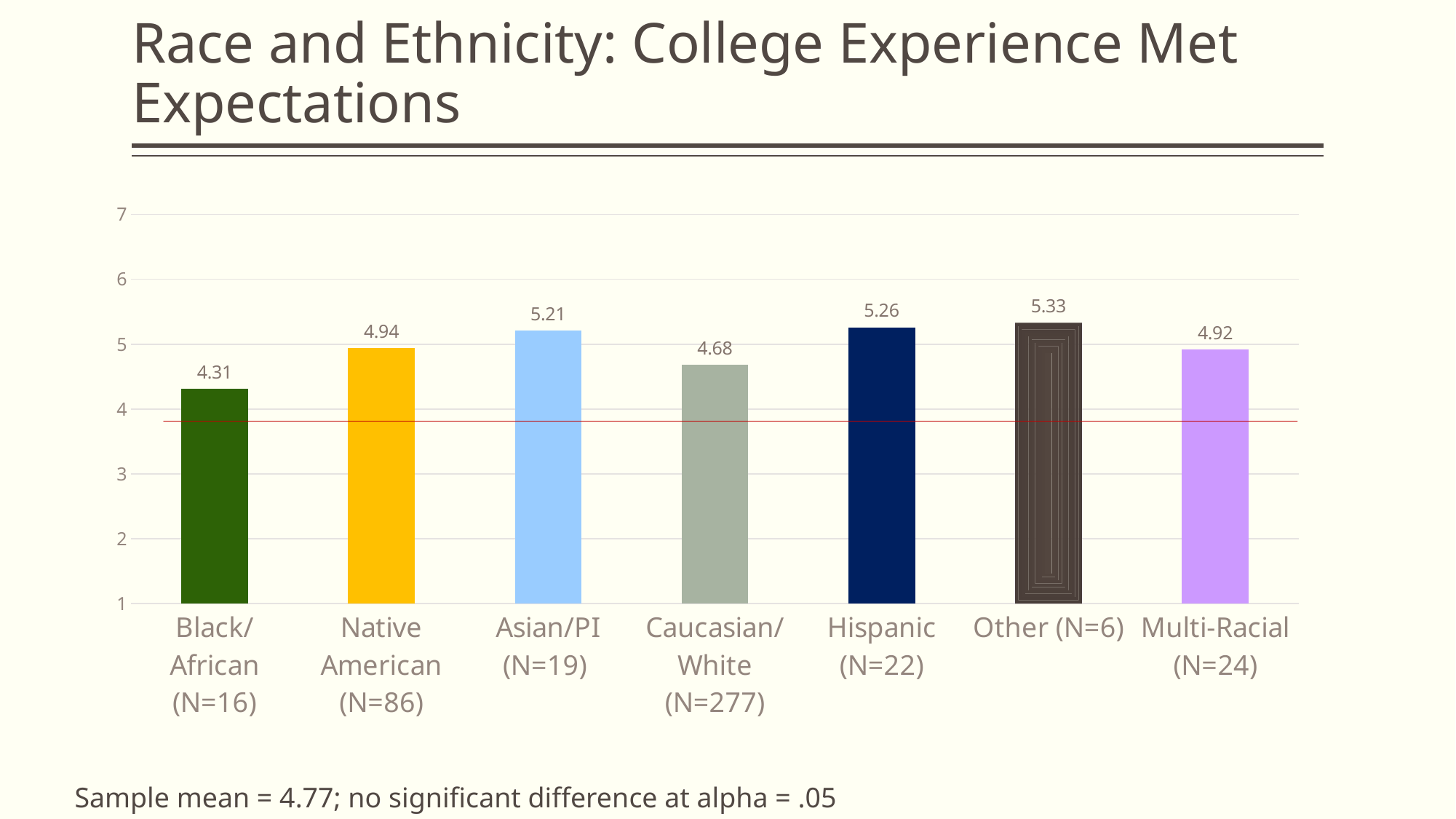
What sample mean is stated in the note below the chart? 4.77 What is the value for Multi-Racial (N=24)? 4.92 What kind of chart is shown on the slide? bar chart How many categories are shown on the chart? 7 Which category has the highest value? Other (N=6) Is the value for Caucasian/White (N=277) greater or less than 5? less What is the value for Caucasian/White (N=277)? 4.68 What is the difference between the values for Other (N=6) and Black/African (N=16)? 1.02 Which is larger, the value for Hispanic (N=22) or the value for Native American (N=86)? Hispanic (N=22) What is the value for Black/African (N=16)? 4.31 Which category has the lowest value? Black/African (N=16) What is the difference between the values for Asian/PI (N=19) and Caucasian/White (N=277)? 0.53